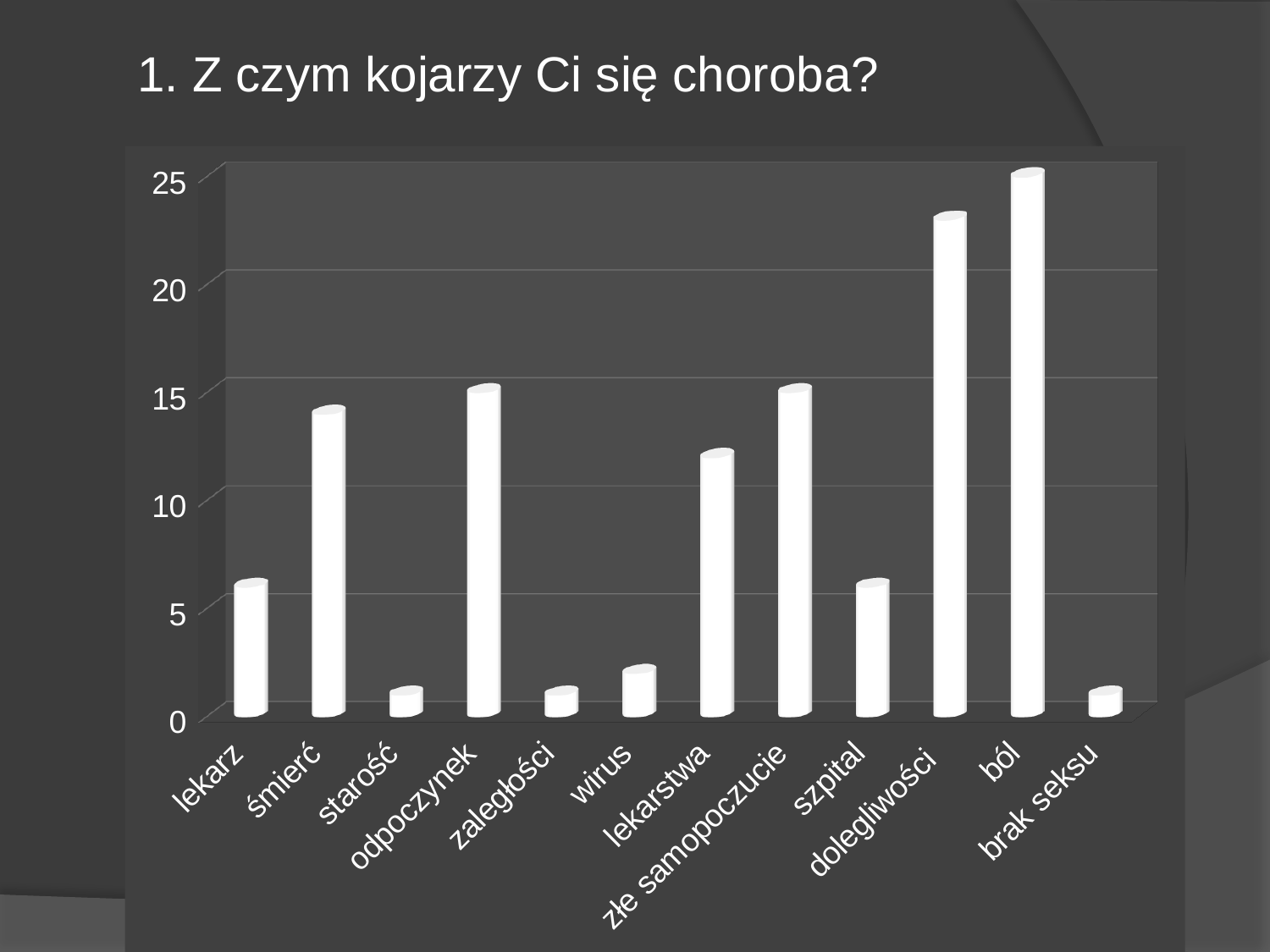
Which is larger, the value for ból or the value for wirus? ból Is the value for wirus greater or less than 5? less Is the value for śmierć greater or less than 10? greater Is the value for lekarstwa greater or less than 10? greater What is the title of the slide? 1. Z czym kojarzy Ci się choroba? Which category has the highest bar? ból Which is larger, the value for szpital or the value for złe samopoczucie? złe samopoczucie What kind of chart is shown on the slide? bar chart How many categories are shown on the x axis of the chart? 12 Which is larger, the value for śmierć or the value for lekarz? śmierć